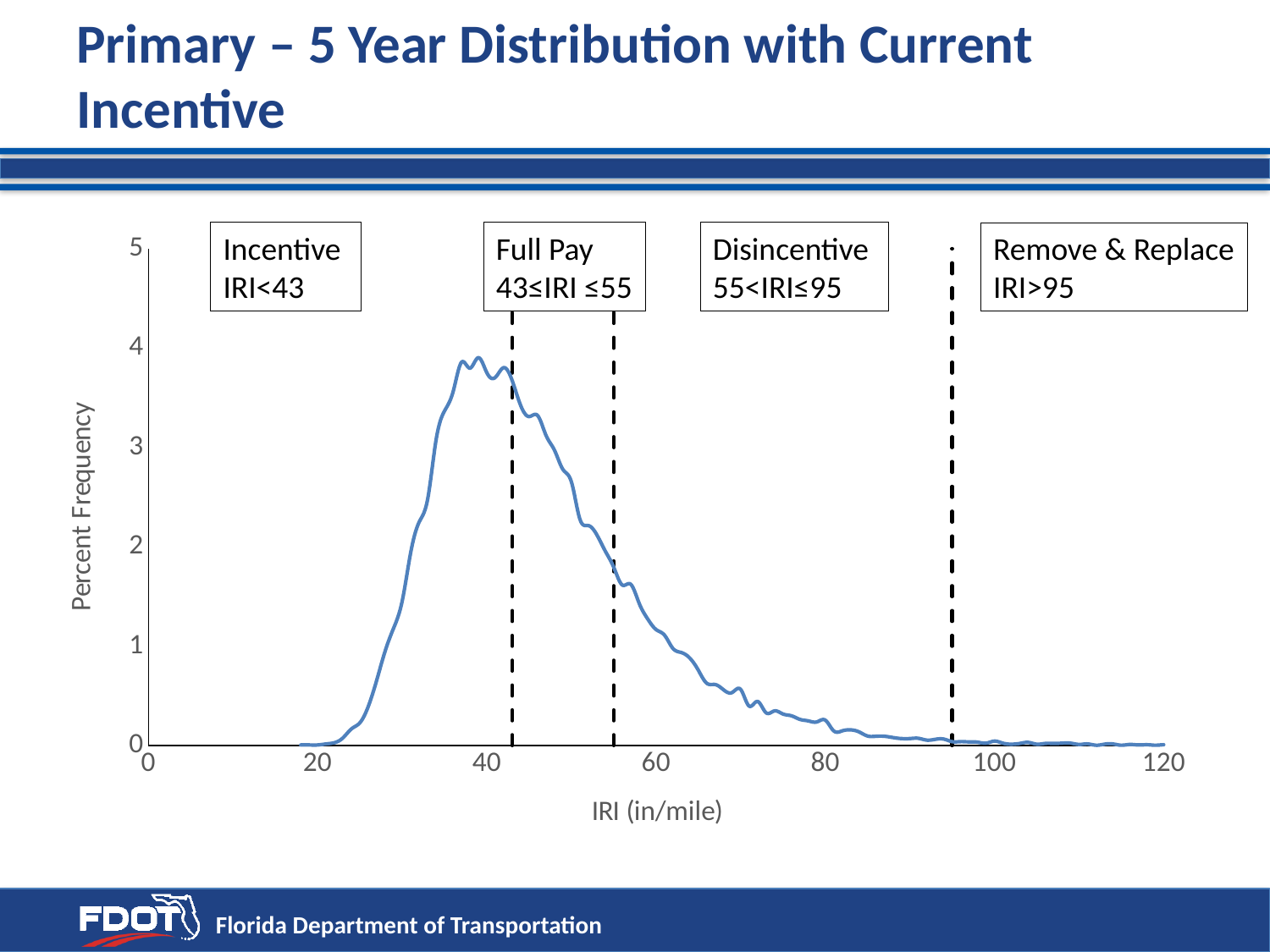
What is the label of the y axis of the chart? Percent Frequency Does the percent frequency rise or fall as IRI increases from 40 to 100? fall Is the percent frequency at IRI = 80 greater or less than 1? less What is the label of the x axis of the chart? IRI (in/mile) Is the percent frequency at IRI = 100 greater or less than 1? less Is the percent frequency at IRI = 20 greater or less than 1? less Does the percent frequency rise or fall as IRI increases from 20 to 35? rise Is the percent frequency at IRI = 40 greater or less than the percent frequency at IRI = 60? greater What kind of chart is shown on the slide? line chart